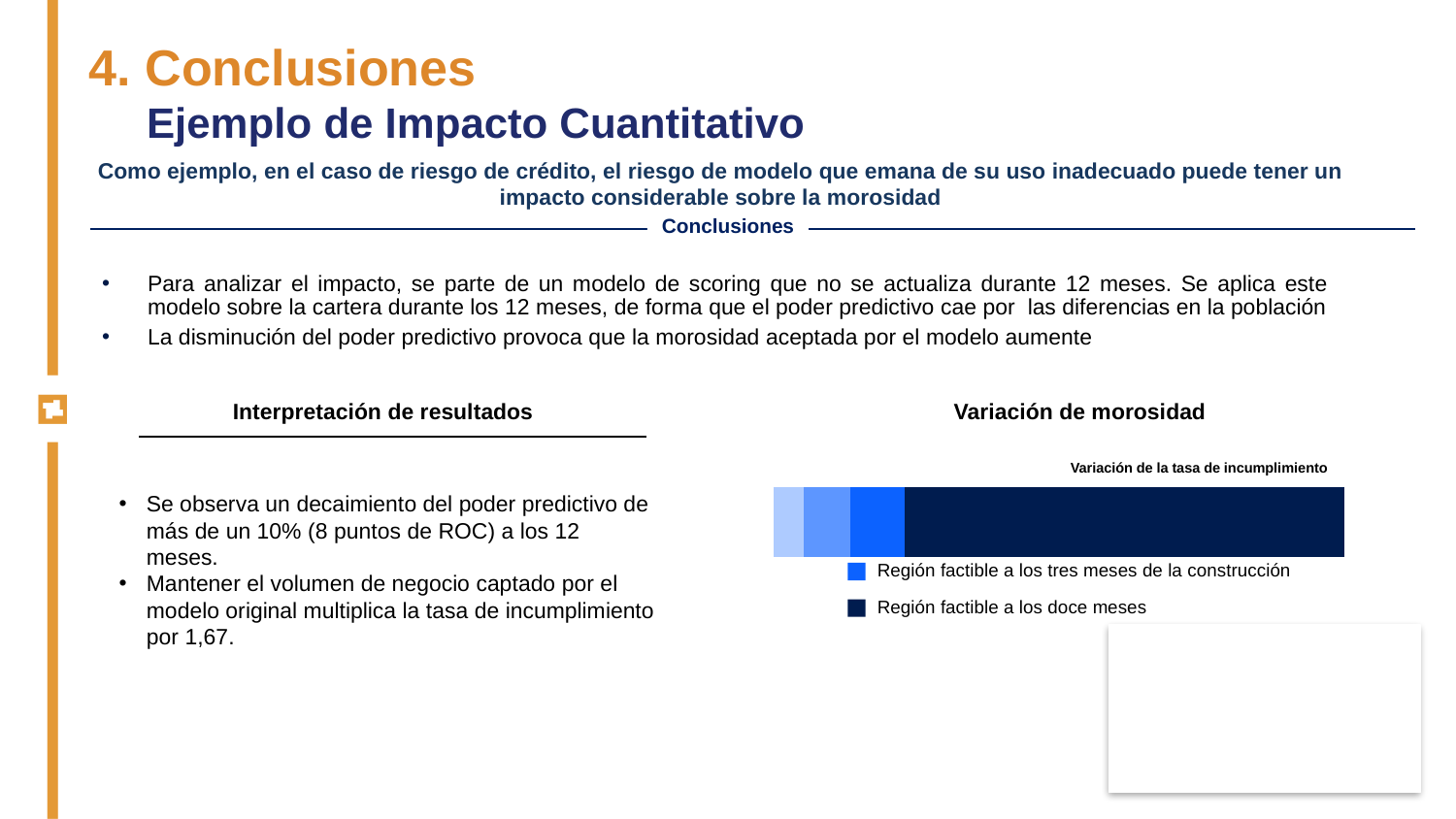
In the 'Variación de la tasa de incumplimiento' chart, which legend entry corresponds to the longest segment of the bar? Región factible a los doce meses In the 'Variación de la tasa de incumplimiento' chart, which legend entry is shown in dark navy blue? Región factible a los doce meses In the 'Variación de la tasa de incumplimiento' chart, which segment of the bar is the longest: the dark navy segment or the bright blue segment? the dark navy segment What is the title printed above the bar in the 'Variación de morosidad' chart? Variación de la tasa de incumplimiento How many entries does the legend of the 'Variación de la tasa de incumplimiento' chart list? 2 What kind of chart is shown under the heading 'Variación de morosidad'? bar chart